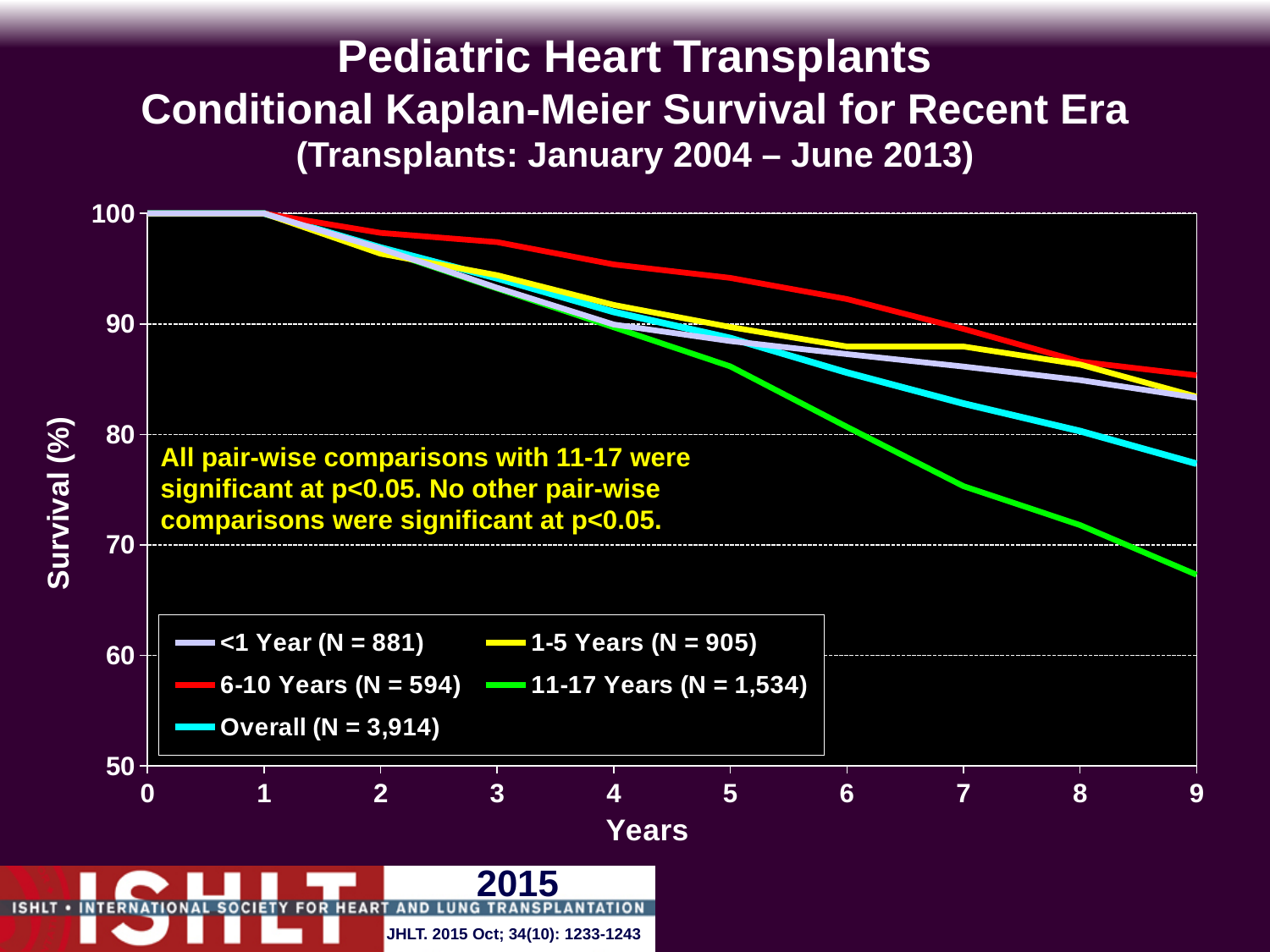
Is the survival value for <1 Year at year 9 greater or less than 80? greater Is the survival value for 6-10 Years at year 5 greater or less than 90? greater Is the survival value for Overall at year 9 greater or less than 80? less Do the survival curves rise or fall as years increase? fall What is the survival value for the Overall series at year 1? 100 How many series does the legend list? 5 What is the N reported in the legend for the Overall series? 3,914 What kind of chart is shown on the slide? line chart At year 8, which is larger: the survival for Overall or for 11-17 Years? Overall Which series has the lowest survival at year 9? 11-17 Years (N = 1,534) Which series has the highest survival at year 9? 6-10 Years (N = 594)